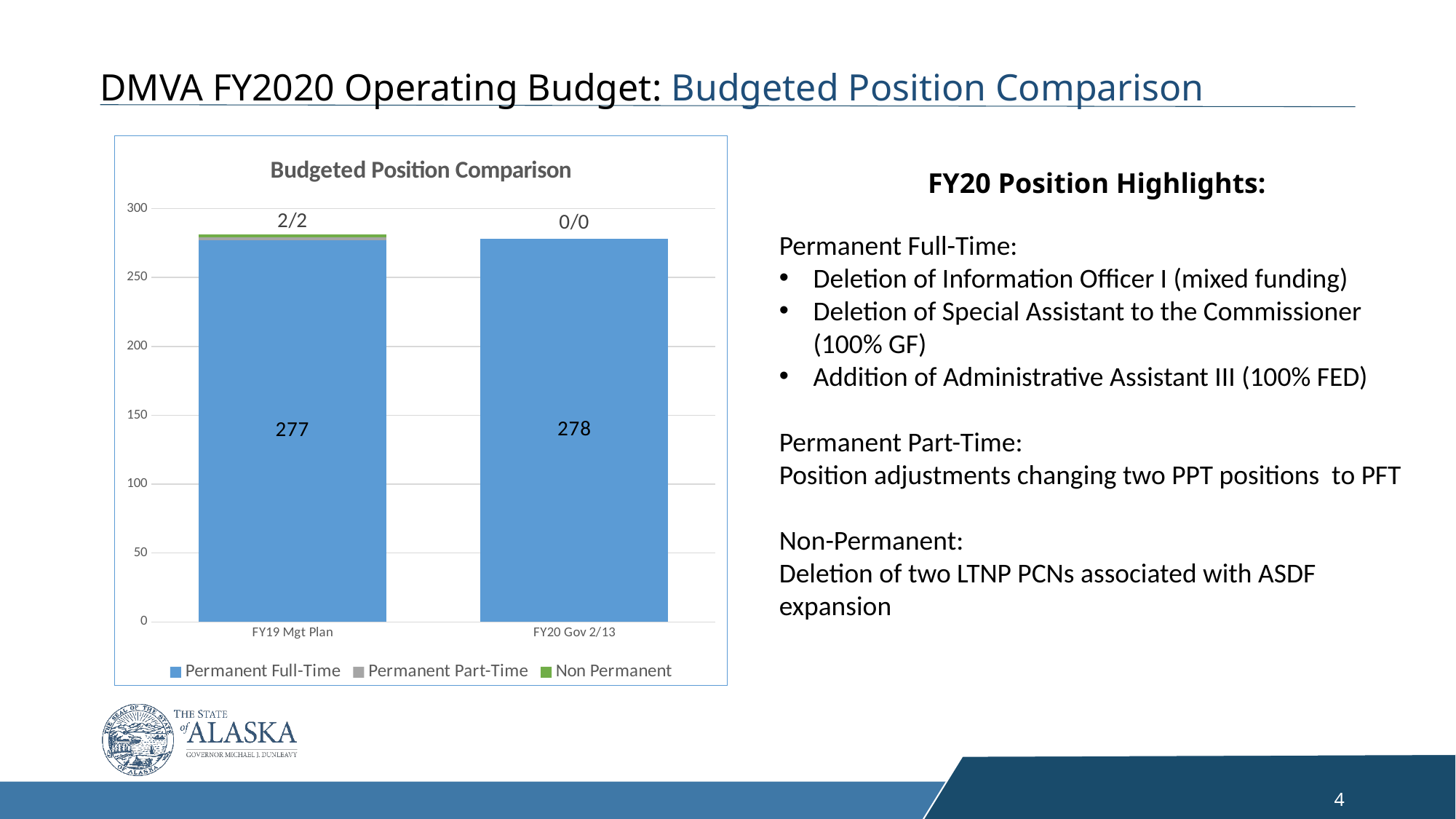
Does the Permanent Full-Time value rise or fall from FY19 Mgt Plan to FY20 Gov 2/13? rise What label is printed above the FY19 Mgt Plan bar? 2/2 What is the difference between the Permanent Full-Time values for FY20 Gov 2/13 and FY19 Mgt Plan? 1 Is the Permanent Full-Time value for FY19 Mgt Plan greater or less than 250? greater How many series does the chart legend list? 3 What is the title of the chart? Budgeted Position Comparison How many categories are shown on the x axis of the chart? 2 What kind of chart is shown on the slide? Stacked bar chart Which category has the lowest Permanent Full-Time value? FY19 Mgt Plan What is the Permanent Full-Time value for FY20 Gov 2/13? 278 What is the Permanent Full-Time value for FY19 Mgt Plan? 277 Which has the larger Permanent Full-Time value, FY19 Mgt Plan or FY20 Gov 2/13? FY20 Gov 2/13